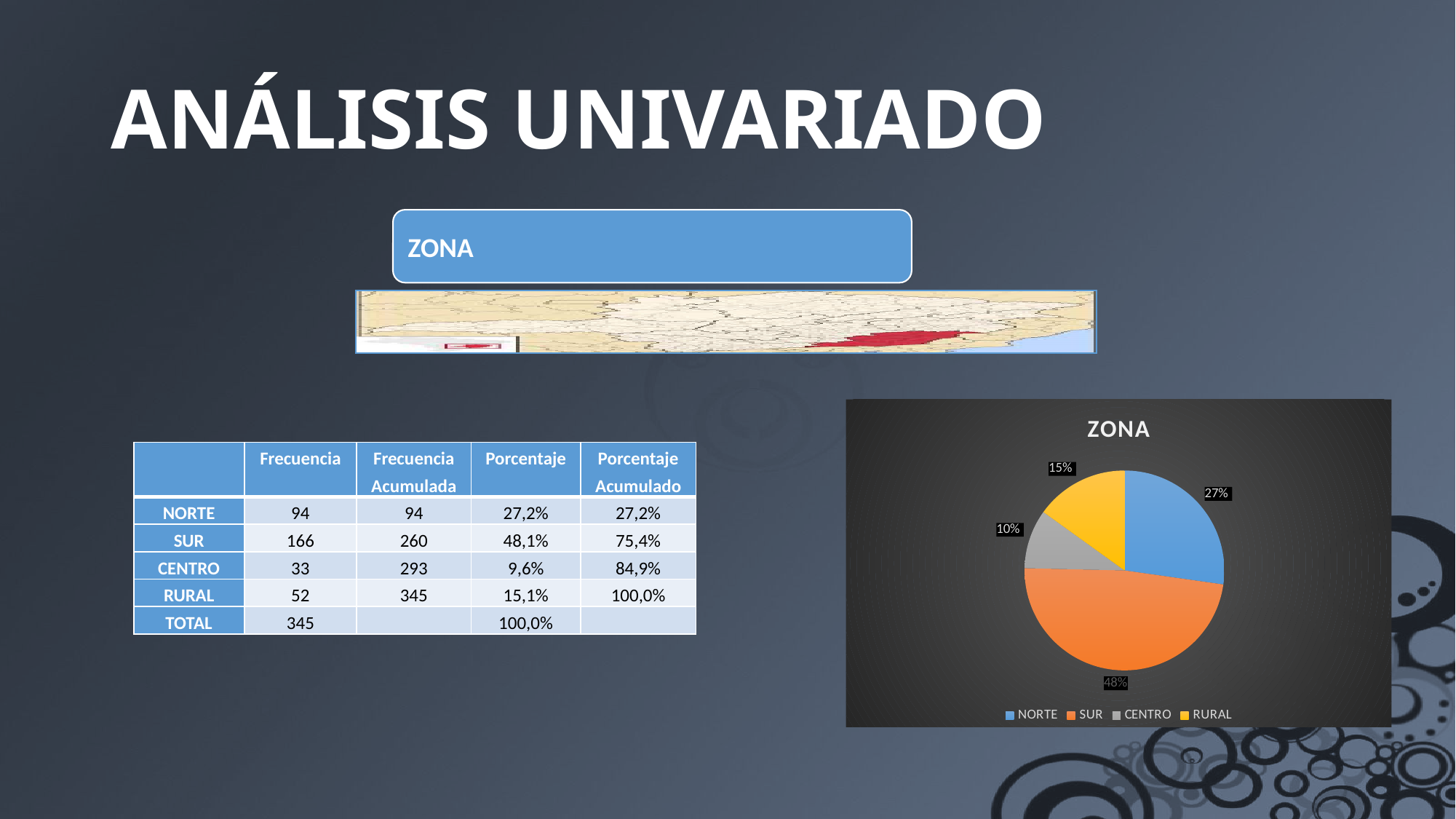
What percentage does the CENTRO slice show in the pie chart? 10% Which slice is larger in the pie chart, NORTE or RURAL? NORTE What percentage does the NORTE slice show in the pie chart? 27% Which zone has the smallest slice in the pie chart? CENTRO How many slices does the pie chart have? 4 Which zone has the largest slice in the pie chart? SUR What percentage does the RURAL slice show in the pie chart? 15% What is the title of the chart? ZONA What is the difference in percentage points between the SUR slice and the NORTE slice? 21 What type of chart is shown on the slide? pie chart How many entries does the chart legend list? 4 What percentage does the SUR slice show in the pie chart? 48%